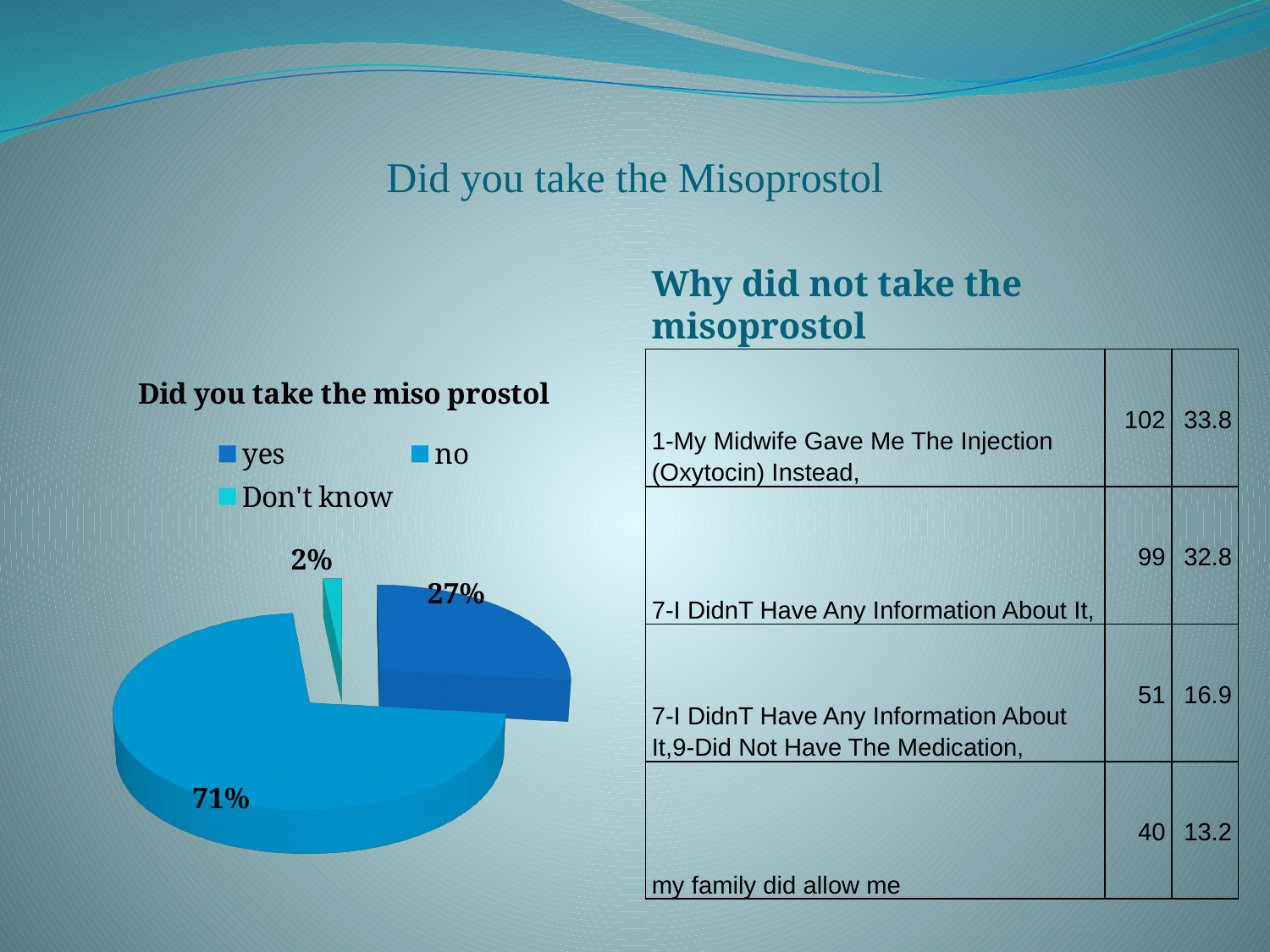
What kind of chart is shown on the slide? pie chart How many slices does the pie chart have? 3 Which category in the legend is shown in the lightest (cyan) colour? Don't know What is the title of the pie chart? Did you take the miso prostol What is the difference in percentage points between the "no" and "yes" slices? 44 What share of the pie does the "no" slice represent? 71% What share of the pie does the "yes" slice represent? 27% Which category has the smallest slice of the pie? Don't know How many categories does the pie chart legend list? 3 What share of the pie does the "Don't know" slice represent? 2% Which slice is larger, "yes" or "Don't know"? yes Which category has the largest slice of the pie? no